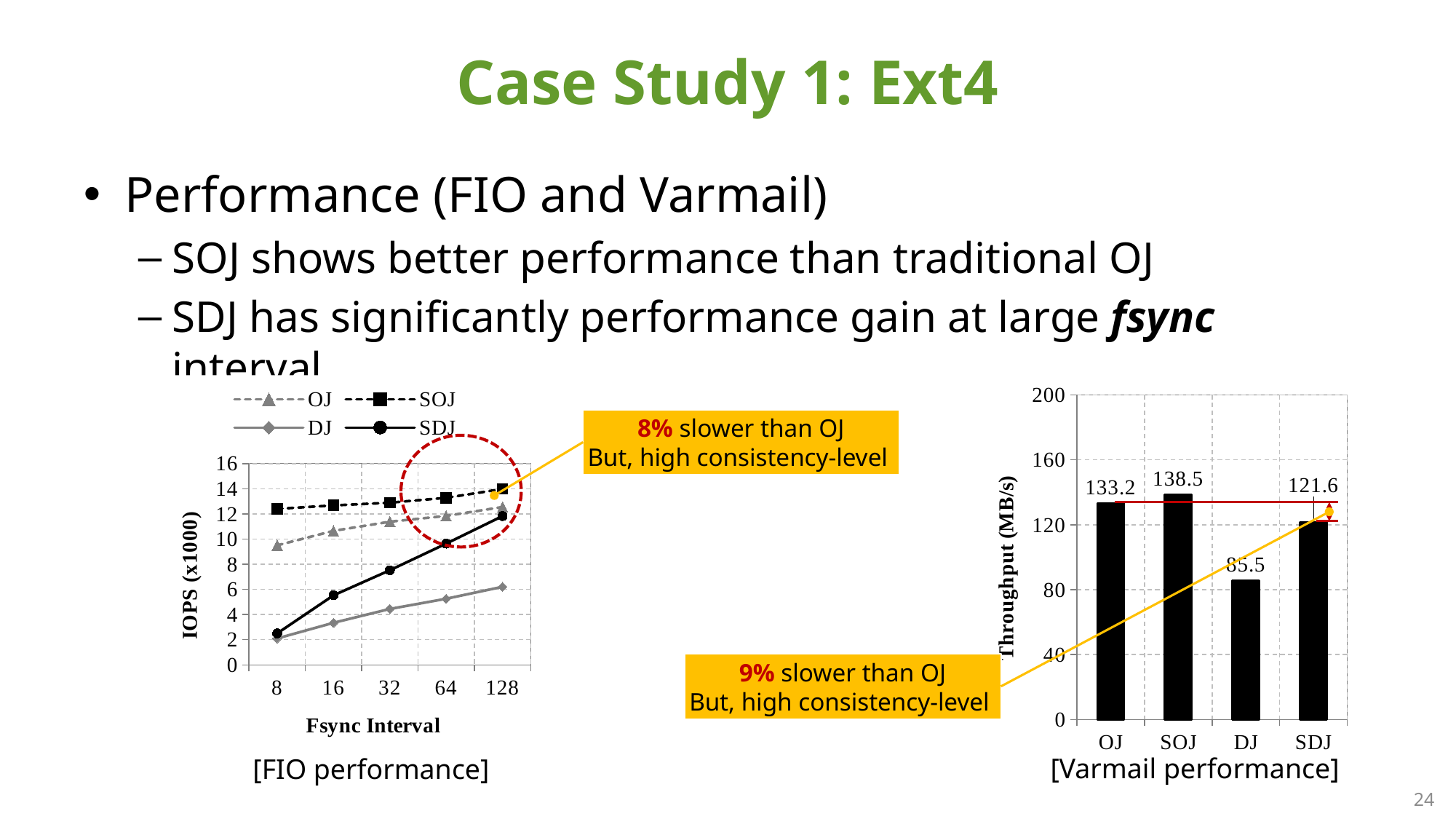
In the Varmail performance chart, what is the difference between the OJ and SDJ throughput values? 11.6 In the Varmail performance chart, which category has the lowest throughput? DJ What kind of chart is the Varmail performance chart? bar chart What is the y-axis label of the Varmail performance chart? Throughput (MB/s) How many series does the legend of the FIO performance chart list? 4 In the Varmail performance chart, what is the throughput for DJ? 85.5 How many bars are in the Varmail performance chart? 4 In the Varmail performance chart, is the throughput for SDJ greater or less than 120? greater In the FIO performance chart, does the SDJ series rise or fall as the fsync interval increases? rise In the Varmail performance chart, what is the throughput for SOJ? 138.5 In the Varmail performance chart, which category has the highest throughput? SOJ In the FIO performance chart, at fsync interval 8, is the IOPS value for SOJ greater or less than 12? greater